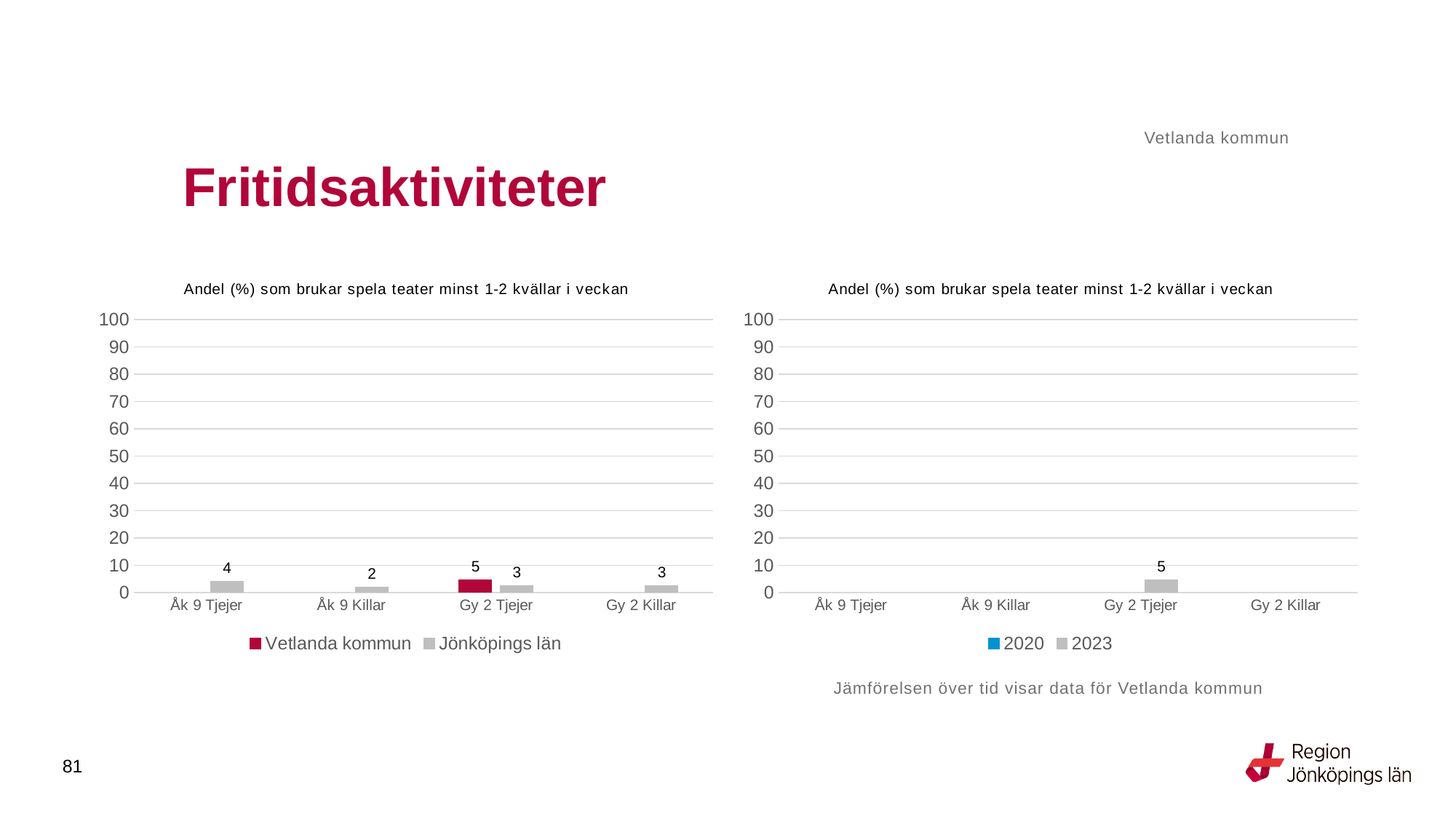
How many series does the legend of the right chart list? 2 In the left chart, what is the value for Jönköpings län for Gy 2 Killar? 3 How many categories are shown on the x axis of the left chart? 4 In the left chart, which is larger for Gy 2 Tjejer: Vetlanda kommun or Jönköpings län? Vetlanda kommun In the right chart, what is the value for 2023 for Gy 2 Tjejer? 5 What kind of chart is the left chart? Bar chart In the left chart, what is the value for Vetlanda kommun for Gy 2 Tjejer? 5 In the left chart, which category has the highest value for Jönköpings län? Åk 9 Tjejer In the left chart, what is the value for Jönköpings län for Åk 9 Tjejer? 4 In the left chart, what is the difference between Vetlanda kommun and Jönköpings län for Gy 2 Tjejer? 2 In the left chart, which category has the lowest value for Jönköpings län? Åk 9 Killar In the left chart, what is the value for Jönköpings län for Åk 9 Killar? 2